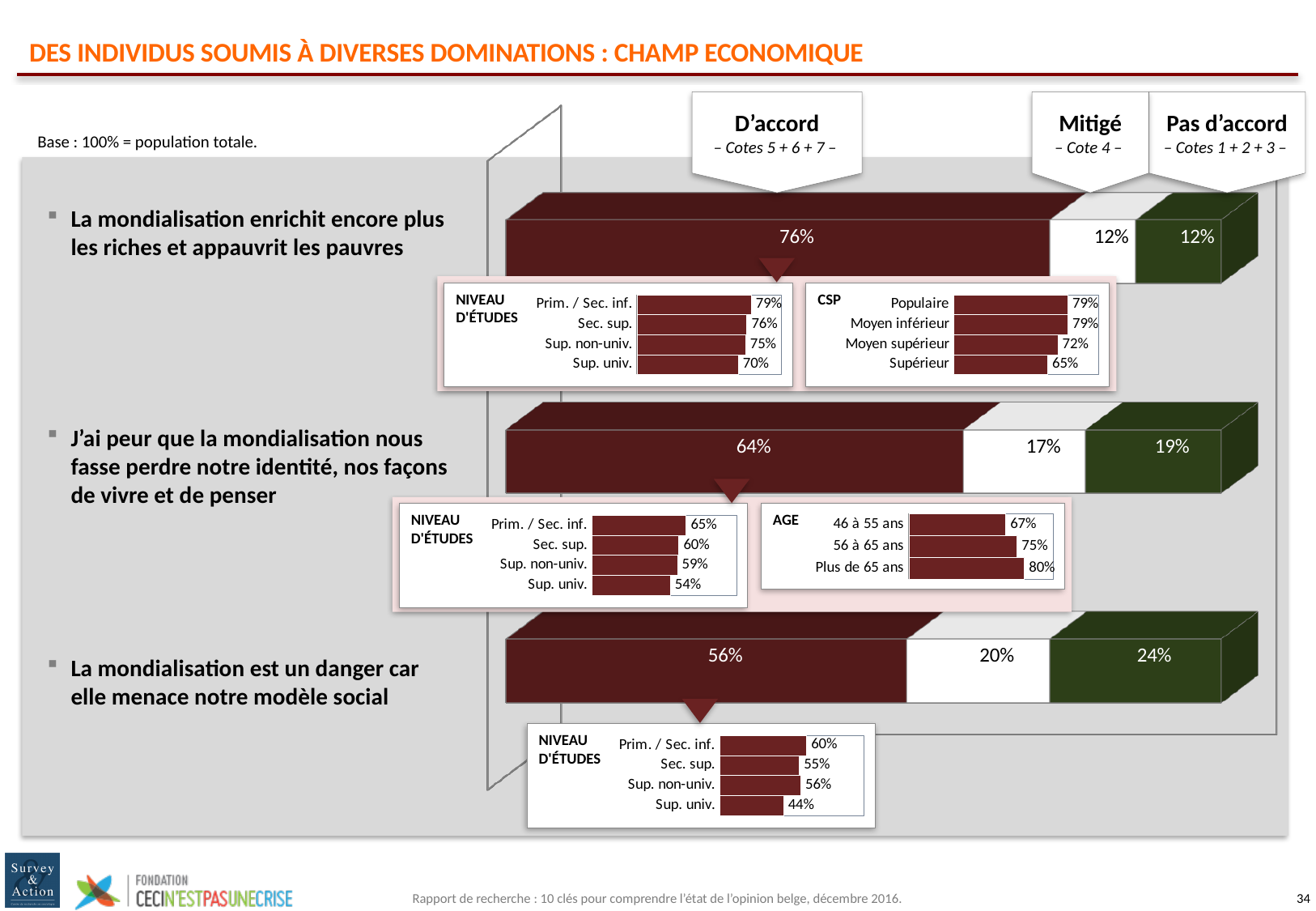
In the 'NIVEAU D'ÉTUDES' breakdown under the third statement (menace notre modèle social), which is larger: 'Sec. sup.' or 'Sup. univ.'? Sec. sup. What type of chart is the main chart showing the three statements? Stacked bar chart In the main stacked bar chart, what percentage is 'D'accord' for the statement 'La mondialisation enrichit encore plus les riches et appauvrit les pauvres'? 76% In the 'NIVEAU D'ÉTUDES' breakdown under the first statement (enrichit les riches), what is the value for 'Sup. univ.'? 70% In the 'AGE' breakdown under the second statement (perdre notre identité), do the values rise or fall as age increases? rise In the 'AGE' breakdown under the second statement (perdre notre identité), what is the value for 'Plus de 65 ans'? 80% In the main stacked bar chart, which statement has the highest 'D'accord' percentage? La mondialisation enrichit encore plus les riches et appauvrit les pauvres In the main stacked bar chart, what is the 'Mitigé' percentage for the statement 'J'ai peur que la mondialisation nous fasse perdre notre identité, nos façons de vivre et de penser'? 17% How many response categories does the main stacked bar chart show for each statement (D'accord, Mitigé, Pas d'accord)? 3 In the 'CSP' breakdown under the first statement (enrichit les riches), which category has the lowest value? Supérieur In the main stacked bar chart, what is the difference between the 'D'accord' percentages for 'La mondialisation enrichit encore plus les riches et appauvrit les pauvres' and 'La mondialisation est un danger car elle menace notre modèle social'? 20 percentage points In the main stacked bar chart, what percentage is 'Pas d'accord' for the statement 'La mondialisation est un danger car elle menace notre modèle social'? 24%